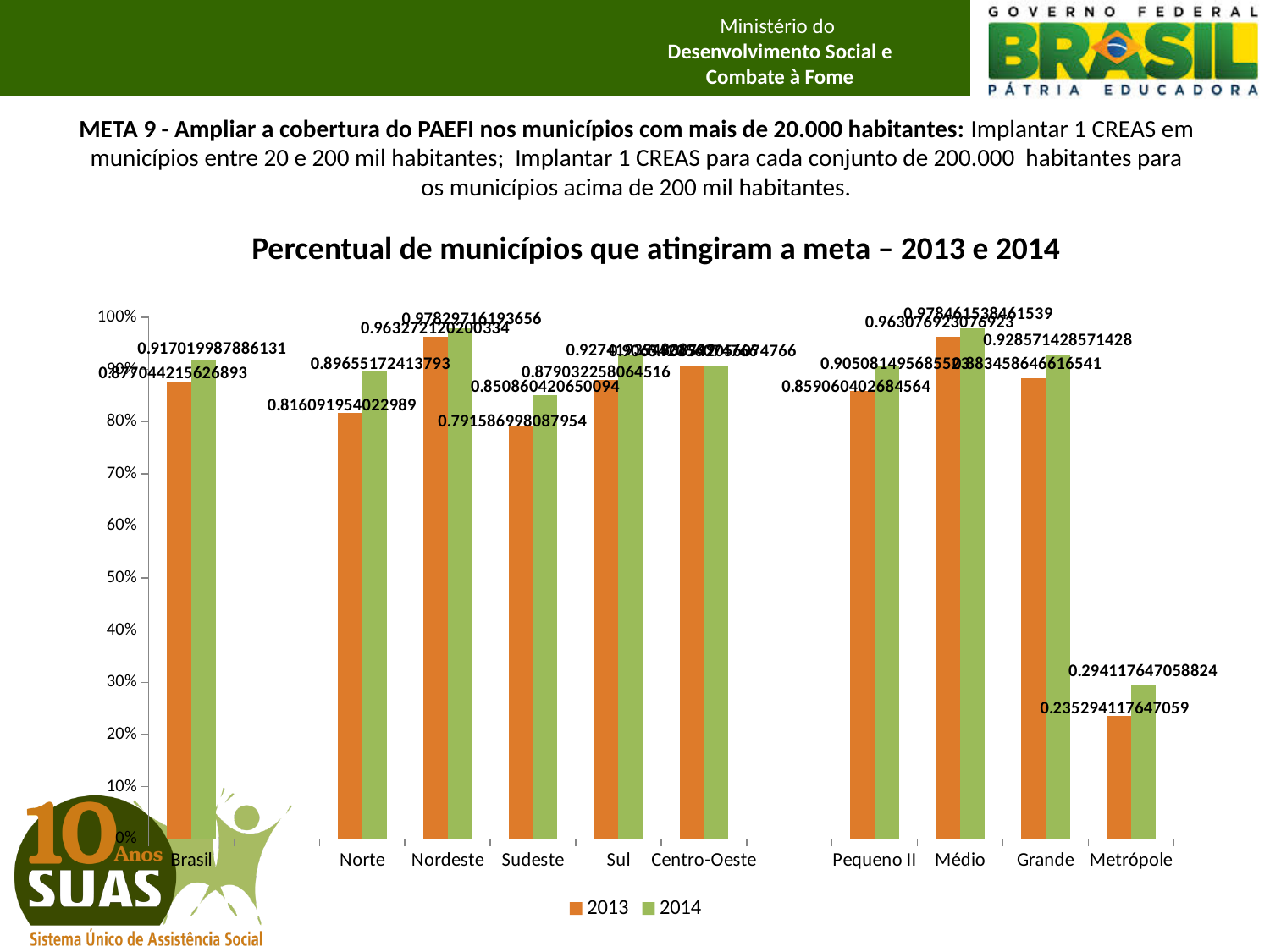
What is the value for Sudeste in 2013? 0.791586998087954 Is the 2013 value for Metrópole greater or less than 30%? less Which category has the lowest value in 2013? Metrópole Which is larger, the 2014 value for Norte or the 2014 value for Sudeste? Norte What is the value for Brasil in 2014? 0.917019987886131 What is the value for Norte in 2013? 0.816091954022989 How many series does the legend list? 2 What is the value for Metrópole in 2014? 0.294117647058824 How many categories are shown on the x axis? 10 What is the difference between the 2014 and 2013 values for Metrópole? 0.058823529411765 What kind of chart is shown on the slide? bar chart What is the value for Médio in 2014? 0.978461538461539